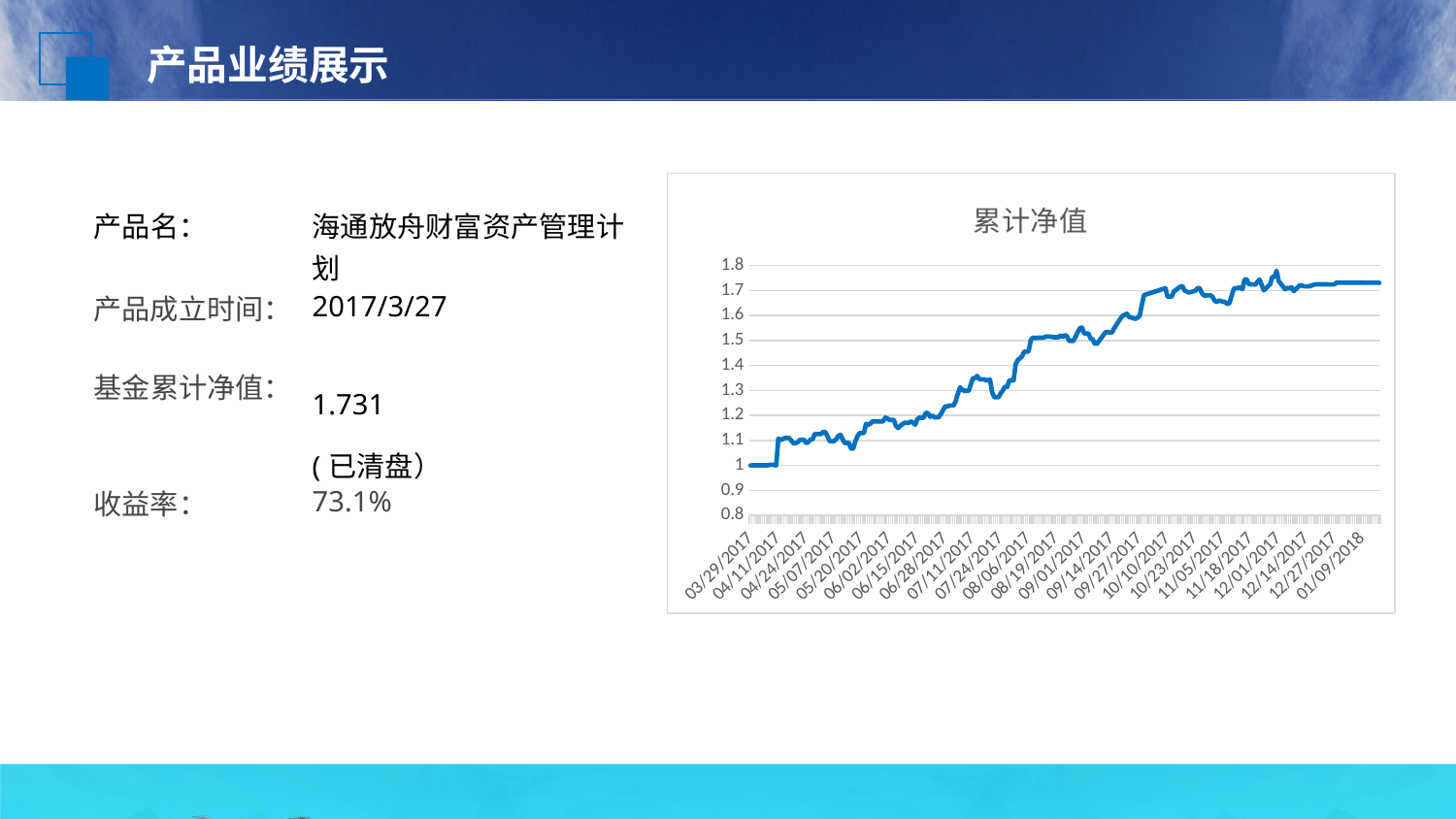
In the 累计净值 chart, is the value at 04/11/2017 greater or less than 1.2? less In the 累计净值 chart, is the value at 10/10/2017 greater or less than 1.6? greater What is the title of the chart on the slide? 累计净值 What kind of chart is shown on the slide? line chart Do the values in the 累计净值 chart generally rise or fall from left to right along the x axis? rise What is the highest value shown on the y axis of the 累计净值 chart? 1.8 In the 累计净值 chart, what is the value at the first date, 03/29/2017? 1 In the 累计净值 chart, is the value at 01/09/2018 greater or less than 1.5? greater What is the last date label on the x axis of the 累计净值 chart? 01/09/2018 In the 累计净值 chart, which date has the larger value, 03/29/2017 or 01/09/2018? 01/09/2018 In the 累计净值 chart, which date has the larger value, 06/15/2017 or 09/14/2017? 09/14/2017